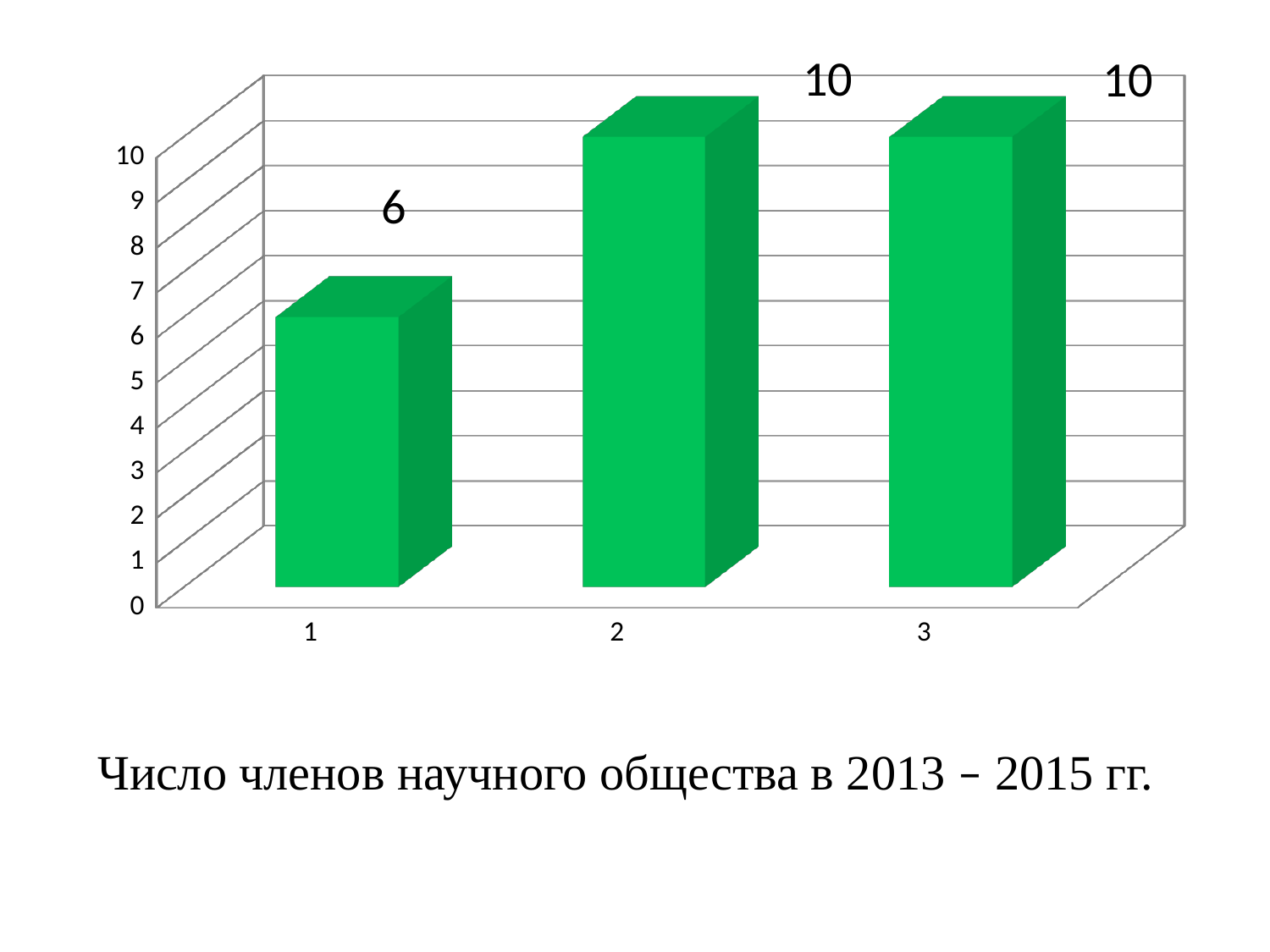
What is the value for category 3? 10 Which category has the lowest value? 1 Do the values rise or fall from category 1 to category 2? rise What is the caption text below the chart? Число членов научного общества в 2013 – 2015 гг. What colour are the bars in the chart? green What is the value for category 1? 6 How many bars are shown in the chart? 3 What is the difference between the values for category 2 and category 1? 4 What is the value for category 2? 10 Which is larger, the value for category 1 or the value for category 2? category 2 What kind of chart is shown on the slide? bar chart Is the value for category 1 greater or less than 5? greater